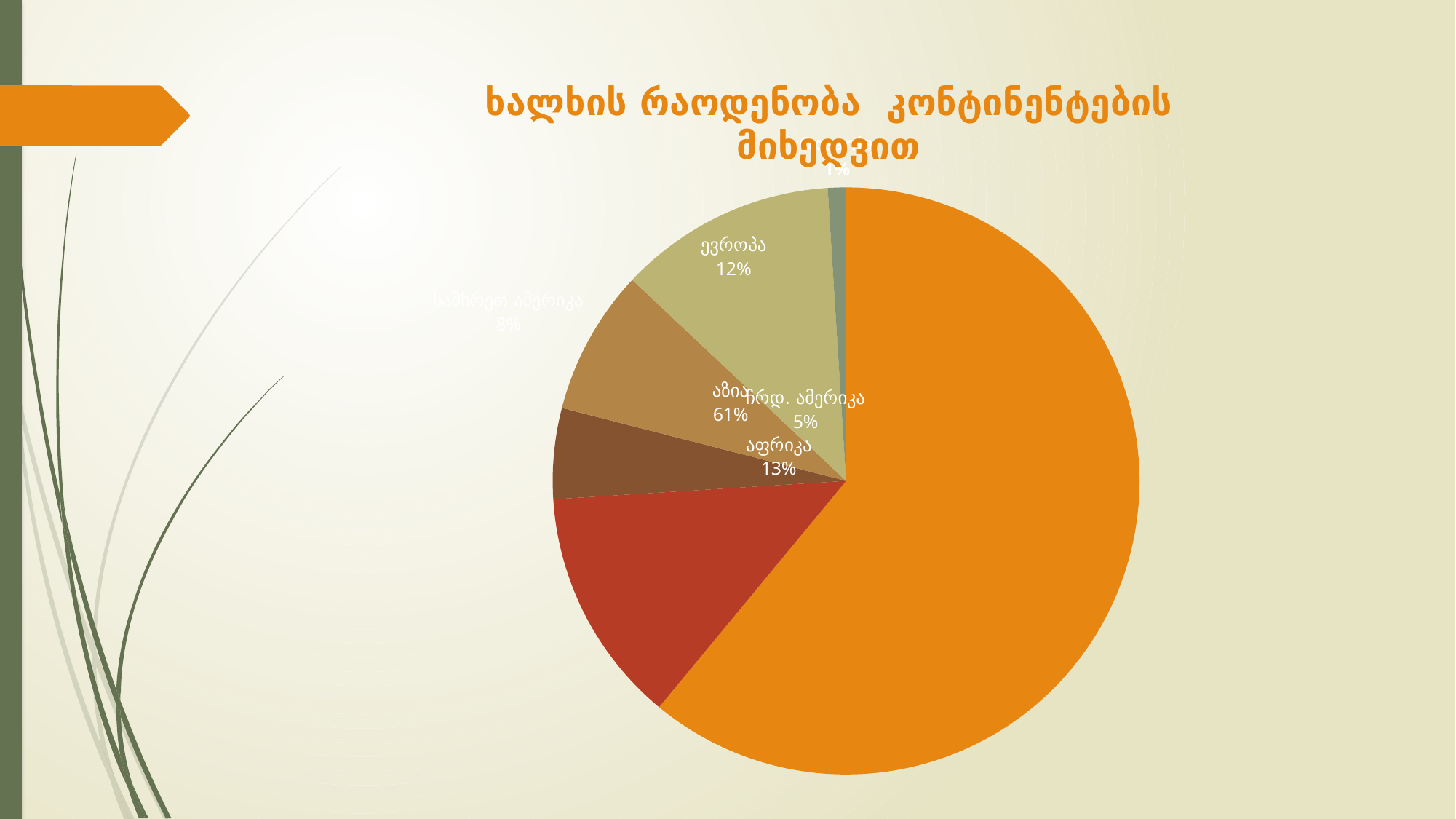
What percentage share does აფრიკა have in the pie chart? 13% Which continent has the largest share in the pie chart? აზია Which is larger, the share of აფრიკა or the share of ევროპა? აფრიკა What percentage share does აზია have in the pie chart? 61% How many slices does the pie chart have? 6 What percentage share does სამხრეთ ამერიკა have in the pie chart? 8% What is the title of the chart? ხალხის რაოდენობა კონტინენტების მიხედვით What kind of chart is shown on the slide? pie chart What colour is the slice for აზია? orange What percentage share does ევროპა have in the pie chart? 12% What is the difference between the share of აზია and the share of აფრიკა? 48% What percentage share does ჩრდ. ამერიკა have in the pie chart? 5%